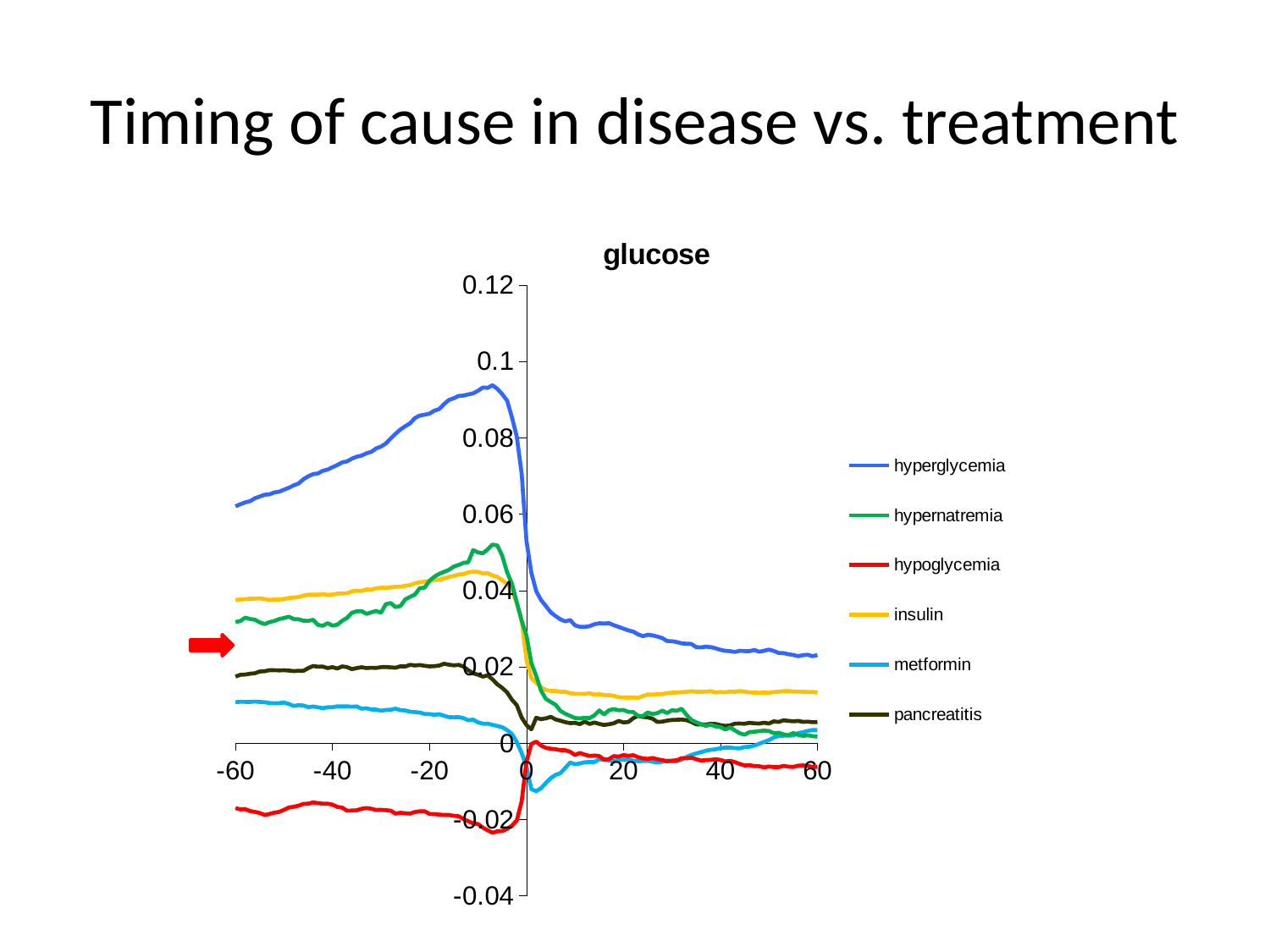
Is the value for hyperglycemia at x = -60 greater or less than 0.04? greater At x = 60, which is larger: hyperglycemia or insulin? hyperglycemia Does the hyperglycemia line rise or fall between x = 0 and x = 60? fall How many series does the legend list? 6 Is the peak value of the hyperglycemia line greater or less than 0.08? greater Which series has the highest value at x = -60? hyperglycemia Is the value for hypoglycemia at x = -60 greater or less than 0? less What kind of chart is shown on the slide? line chart Which series is plotted in red? hypoglycemia What is the title of the chart? glucose Which series has the lowest value at x = -60? hypoglycemia